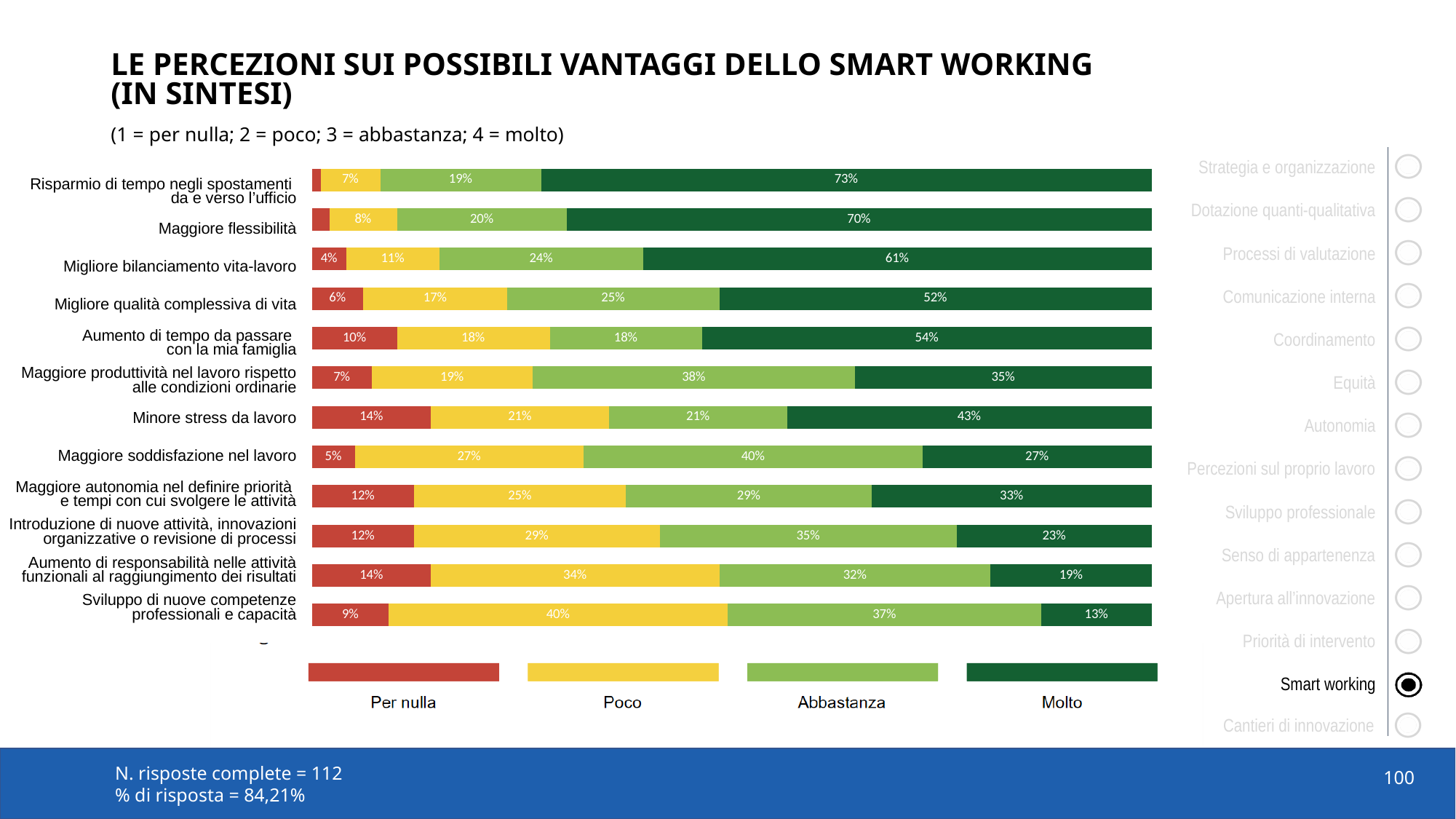
What is the "Abbastanza" value for "Maggiore produttività nel lavoro rispetto alle condizioni ordinarie"? 38% Which category has the highest "Molto" percentage? Risparmio di tempo negli spostamenti da e verso l'ufficio What kind of chart is shown on the slide? Stacked bar chart How many categories (rows) are shown in the chart? 12 What percentage of respondents answered "Molto" for "Risparmio di tempo negli spostamenti da e verso l'ufficio"? 73% Which legend entry is shown in dark green? Molto Which category has the lowest "Molto" percentage? Sviluppo di nuove competenze professionali e capacità What is the difference between the "Molto" values for "Maggiore flessibilità" and "Migliore bilanciamento vita-lavoro"? 9% What is the "Per nulla" value for "Minore stress da lavoro"? 14% How many series does the legend list? 4 Which is larger: the "Molto" value for "Minore stress da lavoro" or for "Maggiore autonomia nel definire priorità e tempi con cui svolgere le attività"? Minore stress da lavoro What is the "Poco" value for "Sviluppo di nuove competenze professionali e capacità"? 40%